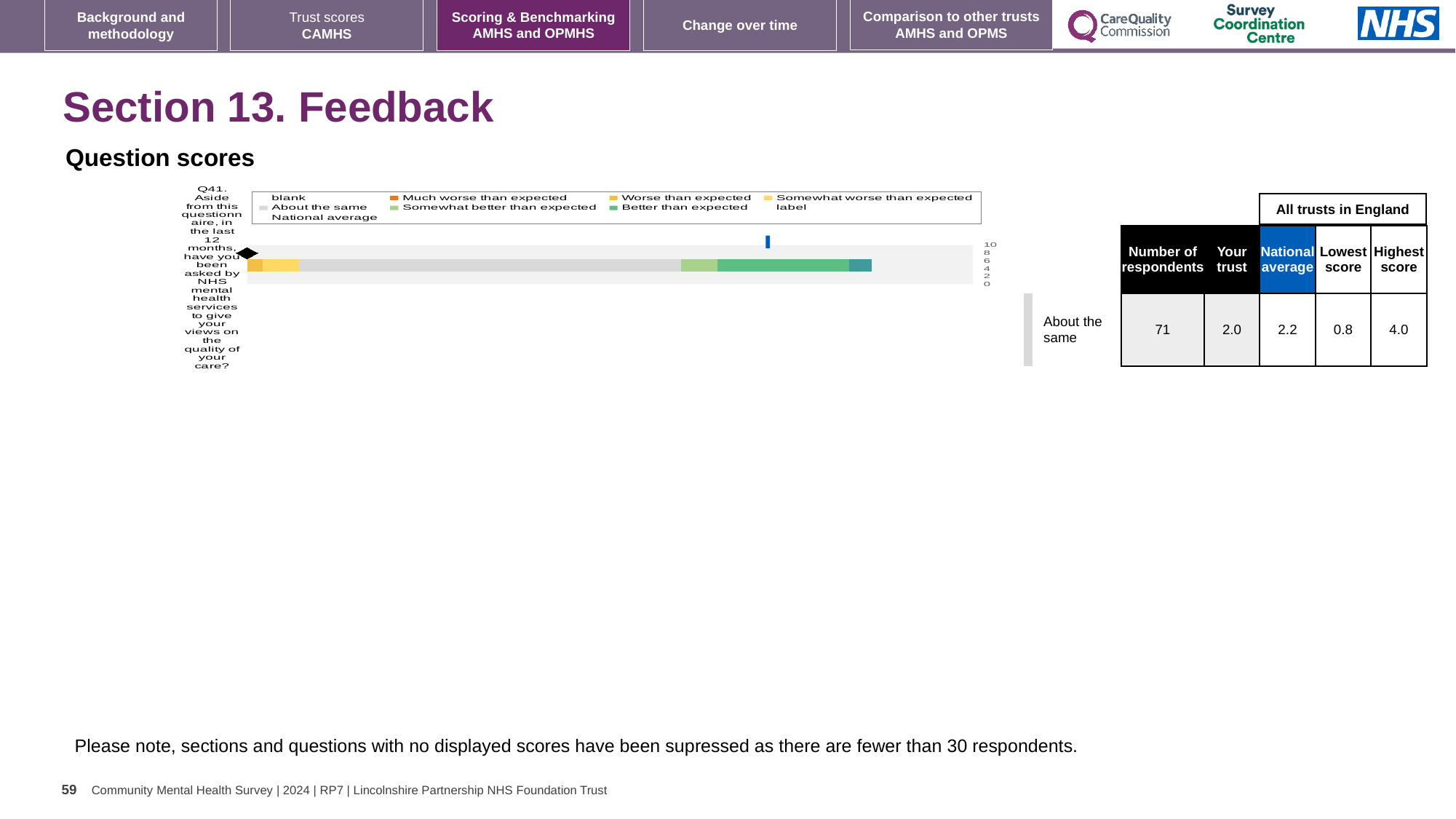
What kind of chart is used to show the Q41 question score? bar chart According to the table beside the chart, what is the highest score among all trusts in England for Q41? 4.0 What is the difference between the highest score (4.0) and the lowest score (0.8) for Q41 in the table? 3.2 For Q41, which is larger: the 'Your trust' score or the national average? National average According to the table beside the chart, what is the 'Your trust' score for Q41? 2.0 What is the highest value shown on the chart's score axis? 10 What benchmark category is shown next to the Q41 chart? About the same How many questions are plotted in the Question scores chart? 1 According to the table beside the chart, how many respondents answered Q41? 71 According to the table beside the chart, what is the national average score for Q41? 2.2 Which question number is plotted in the Question scores chart? Q41